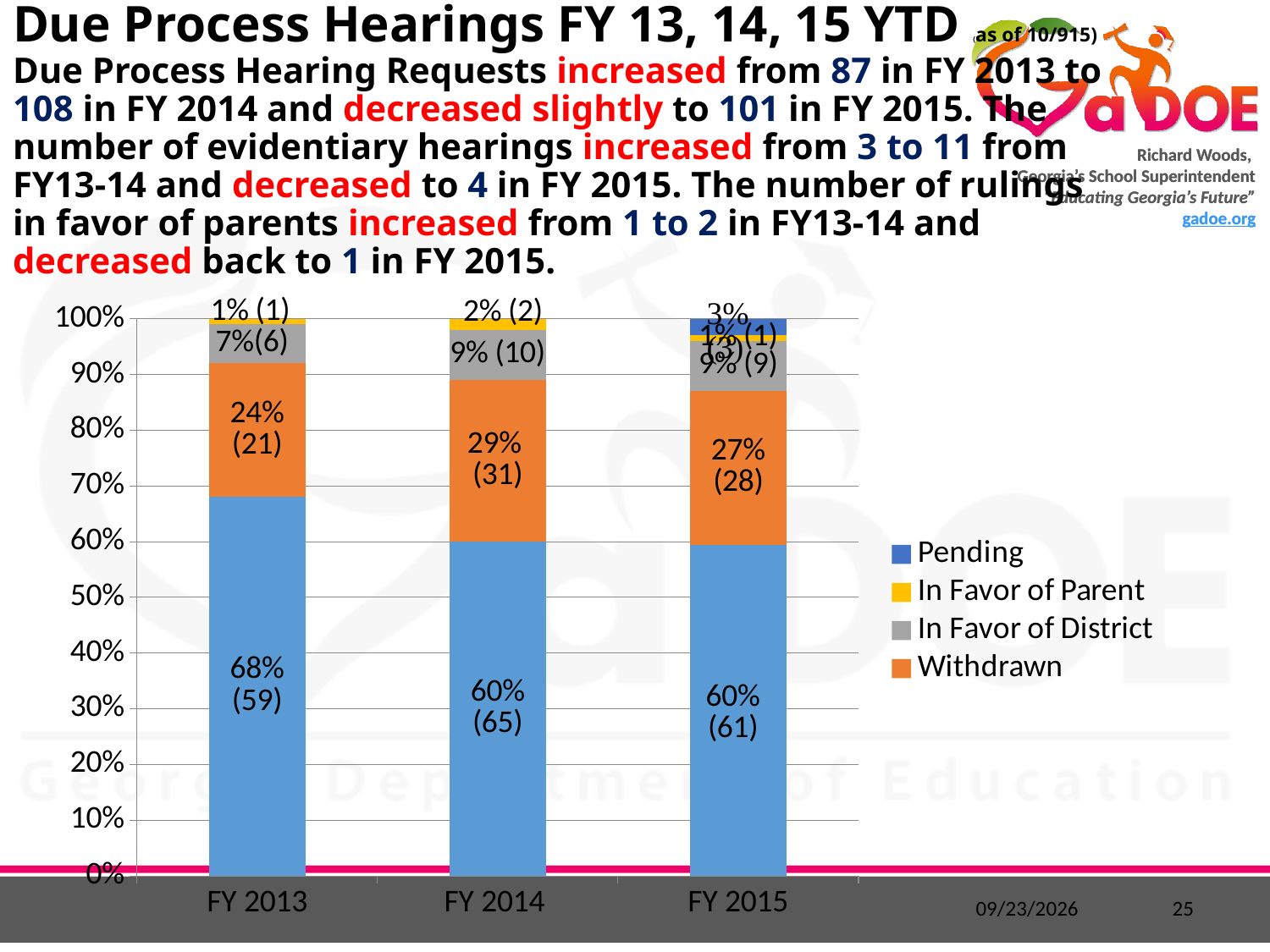
Which fiscal year has the highest percentage for the Pending segment? FY 2015 What kind of chart is shown on the slide? Stacked bar chart What is the data label on the In Favor of District segment for FY 2014? 9% (10) What colour represents Withdrawn in the chart legend? Orange What is the data label on the Withdrawn segment for FY 2014? 29% (31) How many series does the chart legend list? 4 By how many cases did the Withdrawn count increase from FY 2013 (21) to FY 2014 (31)? 10 How many fiscal years are shown on the x axis of the chart? 3 Which fiscal year has the larger Withdrawn percentage, FY 2013 or FY 2014? FY 2014 What is the data label on the Withdrawn segment for FY 2015? 27% (28)